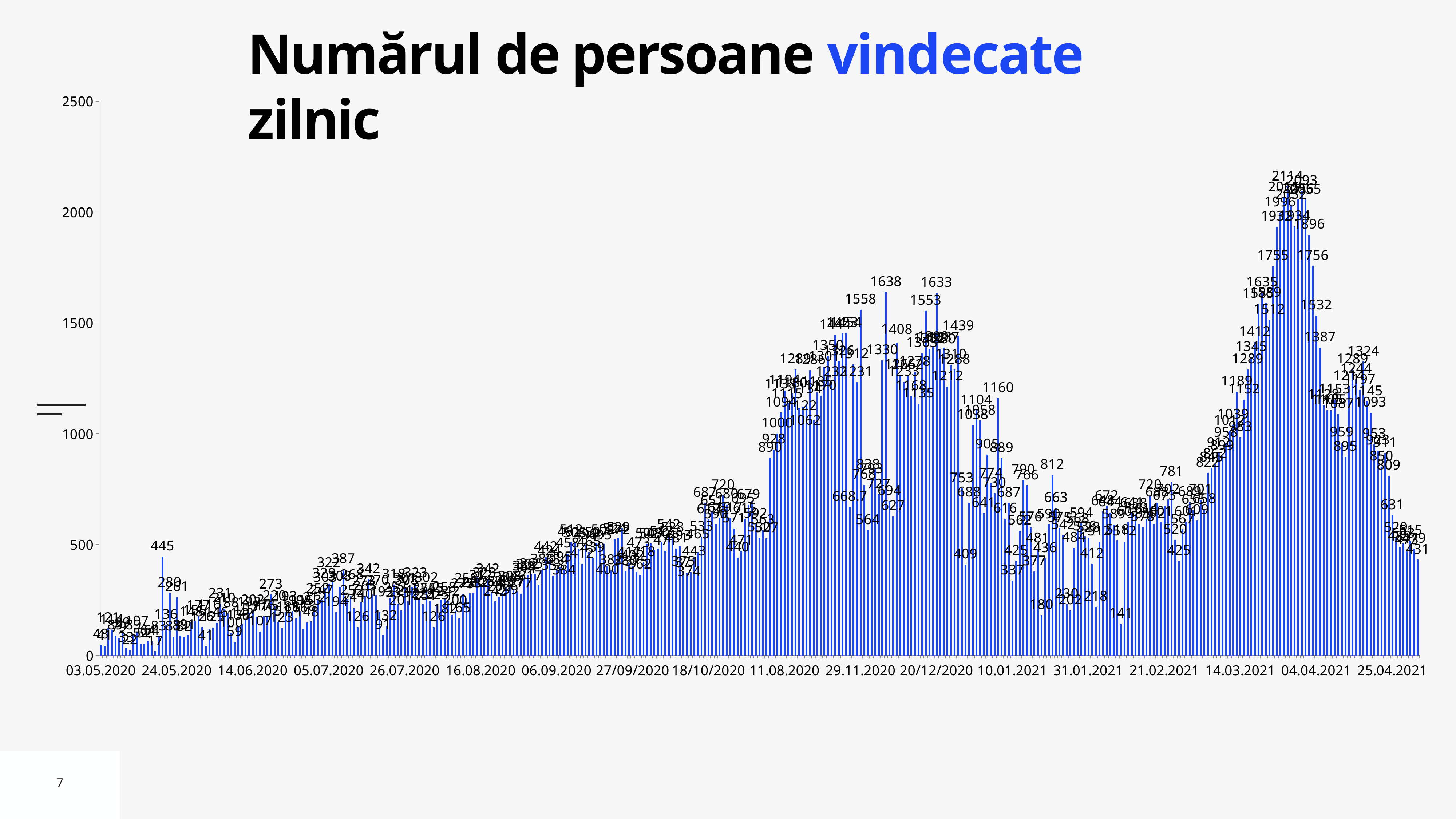
What is the title of the chart? Numărul de persoane vindecate zilnic What kind of chart is shown on the slide? bar chart What is the highest data label shown on the chart? 2114 Which is larger, the peak labeled 2114 or the peak labeled 1638? 2114 What is the difference between the peak labeled 2114 and the peak labeled 1638? 476 What colour are the bars in the chart? blue Is the value of the first bar, at 03.05.2020, greater or less than 500? less Is the value of the tallest bar near 04.04.2021 greater or less than 2000? greater What is the value of the tall spike just before 24.05.2020? 445 Do the values rise or fall between 14.03.2021 and 04.04.2021? rise Do the values rise or fall between 04.04.2021 and 25.04.2021? fall